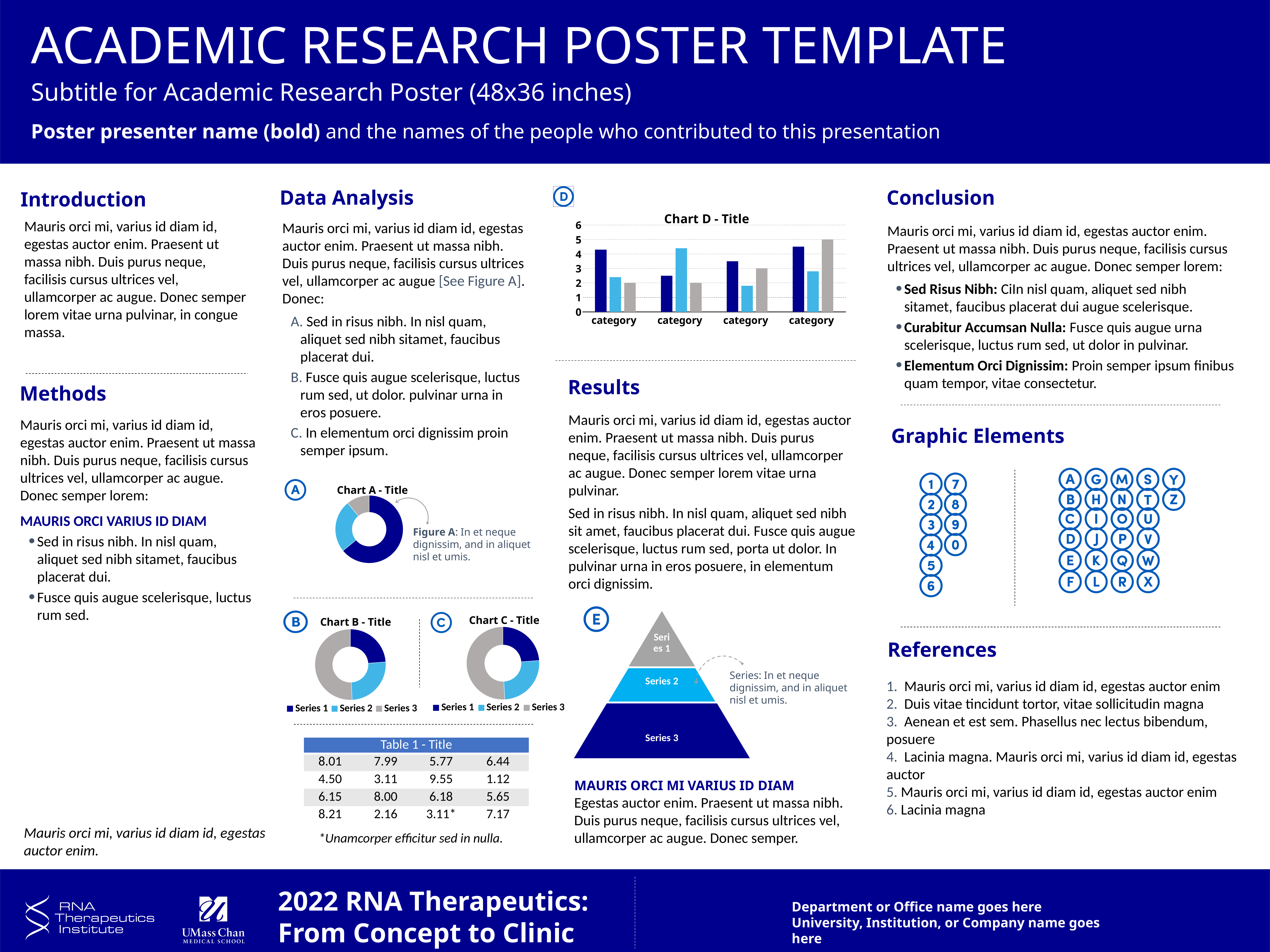
How many series does the legend of Chart B - Title list? 3 In Chart D - Title, is the grey bar in the rightmost category group greater or less than 4? greater What kind of chart is Chart B - Title? donut chart In Chart D - Title, is the light blue bar in the third category group greater or less than 3? less How many series does the legend of Chart C - Title list? 3 What is the highest value shown on the y axis of Chart D - Title? 6 What is the title of the bar chart on the slide? Chart D - Title How many bars are in each category group of Chart D - Title? 3 How many category groups are shown on the x axis of Chart D - Title? 4 Which series has the largest slice in Chart C - Title? Series 3 What kind of chart is Chart D - Title? bar chart Which series has the largest slice in Chart B - Title? Series 3